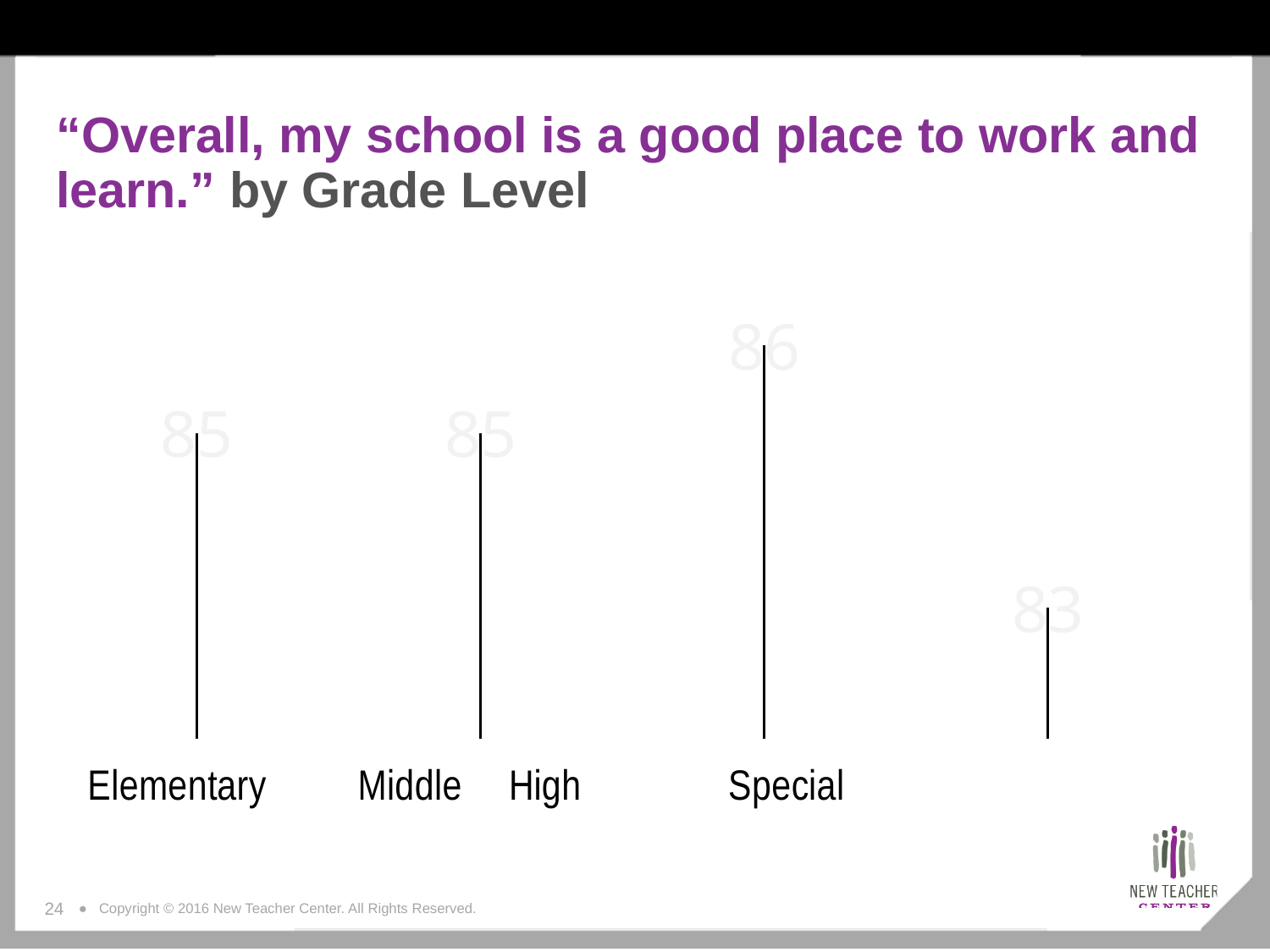
What is the difference between the highest and lowest values in the chart? 3 How many bars are plotted in the chart? 4 What survey statement does the chart title quote? "Overall, my school is a good place to work and learn." What is the value for Elementary? 85 What is the highest value shown in the chart? 86 What is the lowest value shown in the chart? 83 What type of chart is shown on the slide? bar chart How many category labels appear along the bottom of the chart? 4 Which is larger, the value of the third bar or the value of the fourth bar? the third bar By what variable does the chart title say the data is broken down? Grade Level What is the value of the third bar in the chart? 86 What is the value of the first bar in the chart? 85